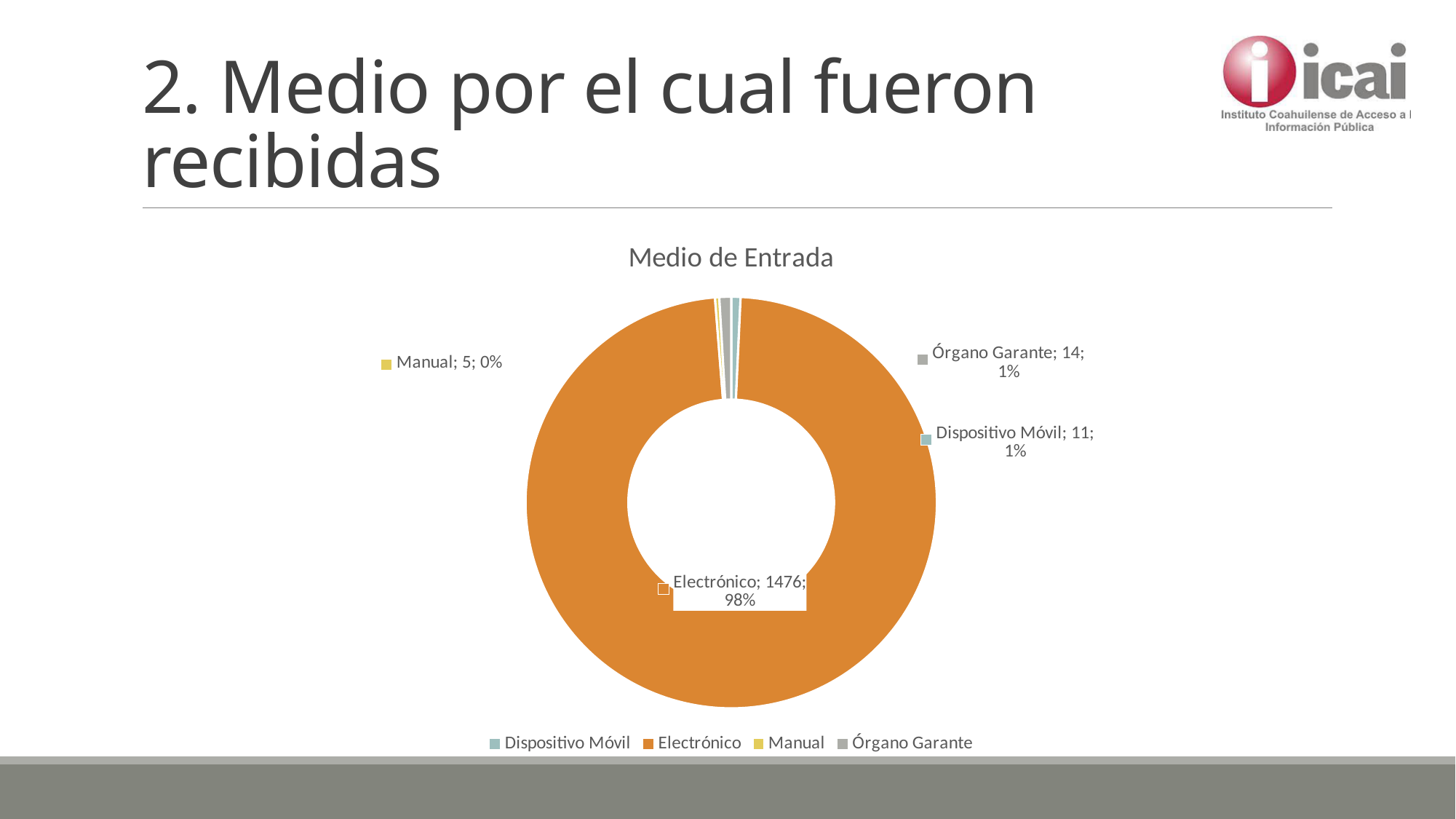
What is the value for Manual in the Medio de Entrada chart? 5 What share of the total does Electrónico represent in the Medio de Entrada chart? 98% What kind of chart is shown on the slide? Doughnut (pie) chart What is the title of the chart on the slide? Medio de Entrada What is the difference between the values for Órgano Garante and Dispositivo Móvil? 3 Which is larger, the value for Órgano Garante or the value for Manual? Órgano Garante What is the value for Electrónico in the Medio de Entrada chart? 1476 What is the value for Órgano Garante in the Medio de Entrada chart? 14 How many categories are shown in the Medio de Entrada chart? 4 Which category has the largest slice in the Medio de Entrada chart? Electrónico What is the value for Dispositivo Móvil in the Medio de Entrada chart? 11 Which category has the smallest slice in the Medio de Entrada chart? Manual